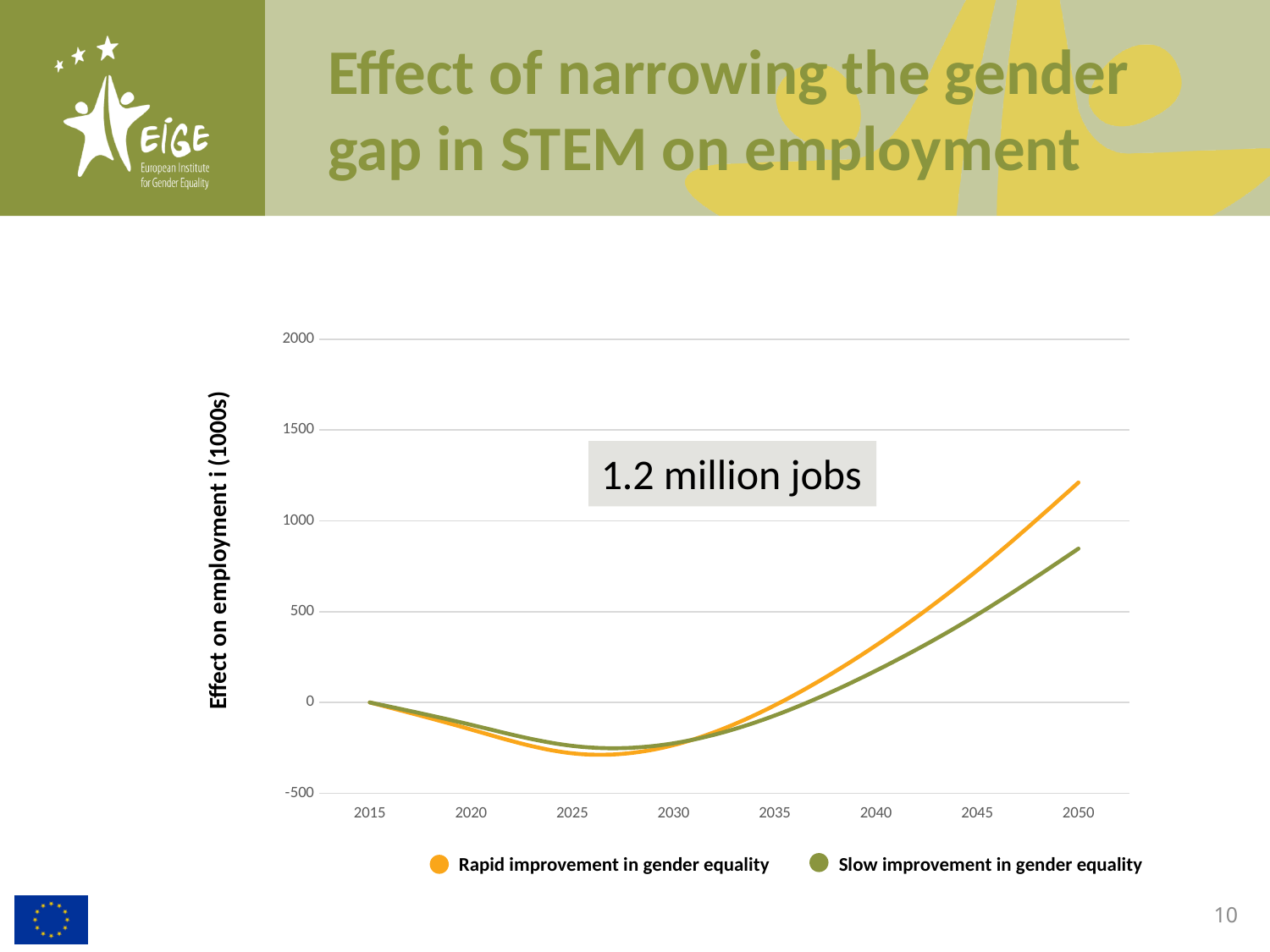
Between 2015 and 2025, do the values for Slow improvement in gender equality rise or fall? fall What kind of chart is shown on the slide? line chart Is the value for Slow improvement in gender equality in 2050 greater or less than 1000? less How many series does the legend list? 2 Between 2030 and 2050, do the values for Rapid improvement in gender equality rise or fall? rise Is the value for Rapid improvement in gender equality in 2050 greater or less than 1000? greater How many year labels are shown on the x axis? 8 Is the value for Slow improvement in gender equality in 2040 greater or less than 500? less What are the two series named in the legend? Rapid improvement in gender equality; Slow improvement in gender equality What is the label on the vertical axis? Effect on employment i (1000s) In 2050, which series has the higher value: Rapid improvement in gender equality or Slow improvement in gender equality? Rapid improvement in gender equality